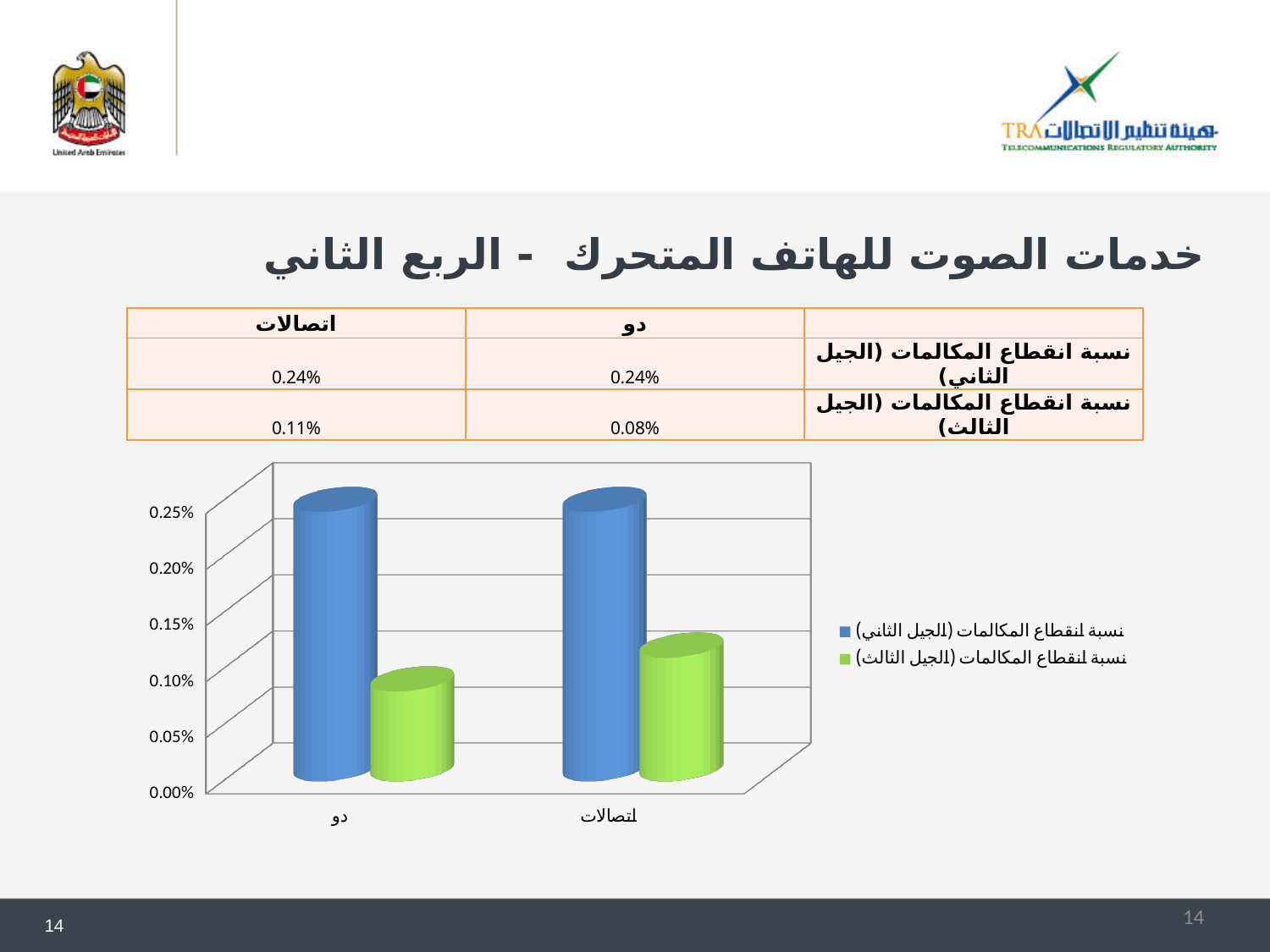
What is the 3G call drop rate (نسبة انقطاع المكالمات (الجيل الثالث)) for دو (du)? 0.08% For دو, what is the difference between the 2G and 3G call drop rates? 0.16% Which operator has the lowest 3G call drop rate (الجيل الثالث)? دو How many operators (categories) are shown on the x axis of the chart? 2 What type of chart is shown on the slide? Bar chart What is the 3G call drop rate (نسبة انقطاع المكالمات (الجيل الثالث)) for اتصالات (Etisalat)? 0.11% What is the difference between the 3G call drop rates of اتصالات and دو? 0.03% How many series does the chart legend list? 2 What is the 2G call drop rate (نسبة انقطاع المكالمات (الجيل الثاني)) for دو (du)? 0.24% Which operator has the higher 3G call drop rate (الجيل الثالث), دو or اتصالات? اتصالات What is the 2G call drop rate (نسبة انقطاع المكالمات (الجيل الثاني)) for اتصالات (Etisalat)? 0.24% Is the 3G call drop rate for اتصالات greater or less than 0.10%? greater